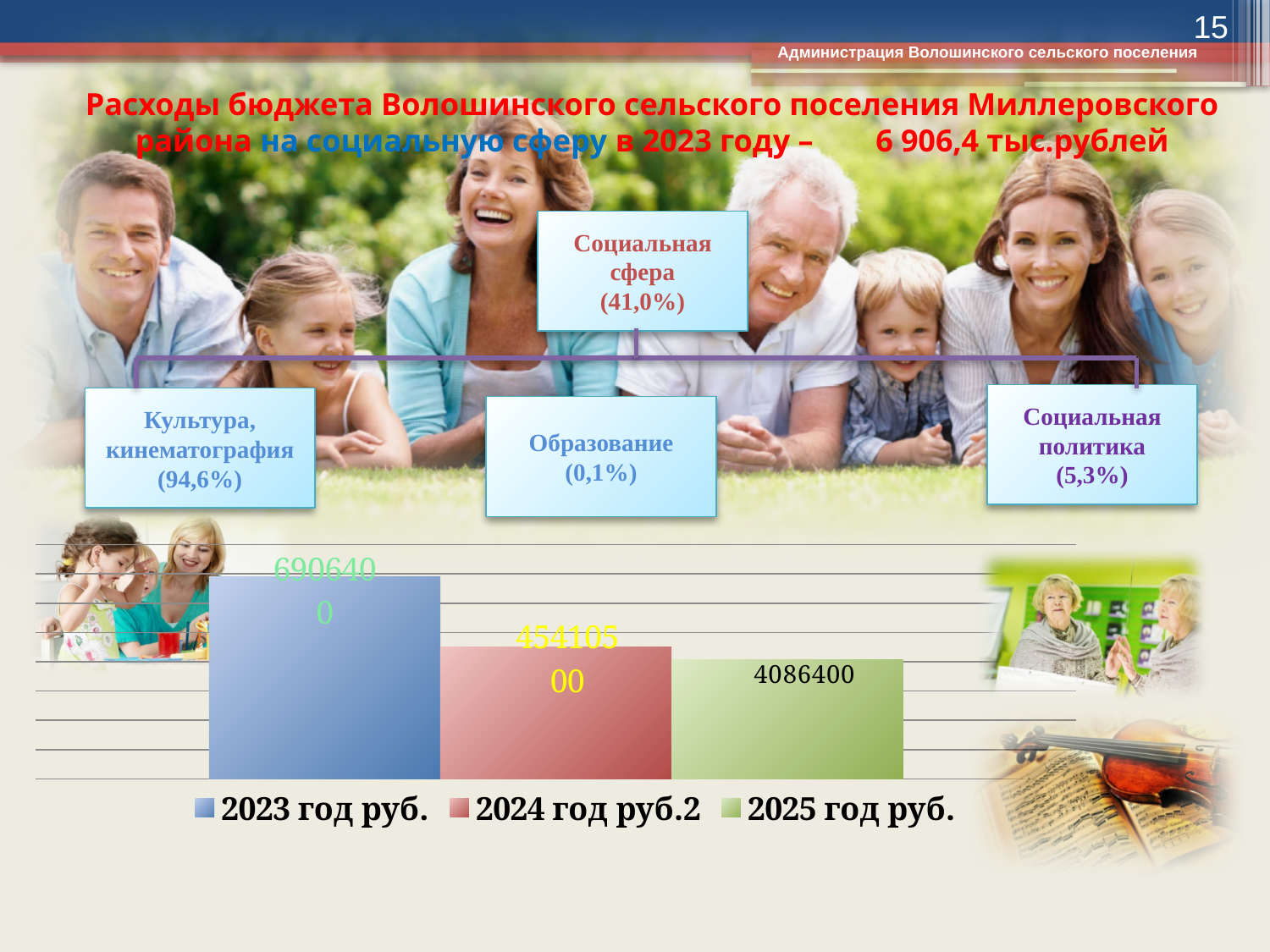
Which bar is taller: 2023 год руб. or 2025 год руб.? 2023 год руб. What is the legend label of the green series? 2025 год руб. What is the difference between the 2023 год руб. value and the 2025 год руб. value? 2820000 What value is shown for the 2023 год руб. bar? 6906400 How many bars are plotted in the chart? 3 What colour is the 2024 год руб.2 series in the legend? red What kind of chart is shown on the slide? bar chart Do the bar heights rise or fall from left to right across the chart? fall Which series has the lowest bar in the chart? 2025 год руб. How many series does the chart legend list? 3 Which series has the highest bar in the chart? 2023 год руб. What value is shown for the 2025 год руб. bar? 4086400